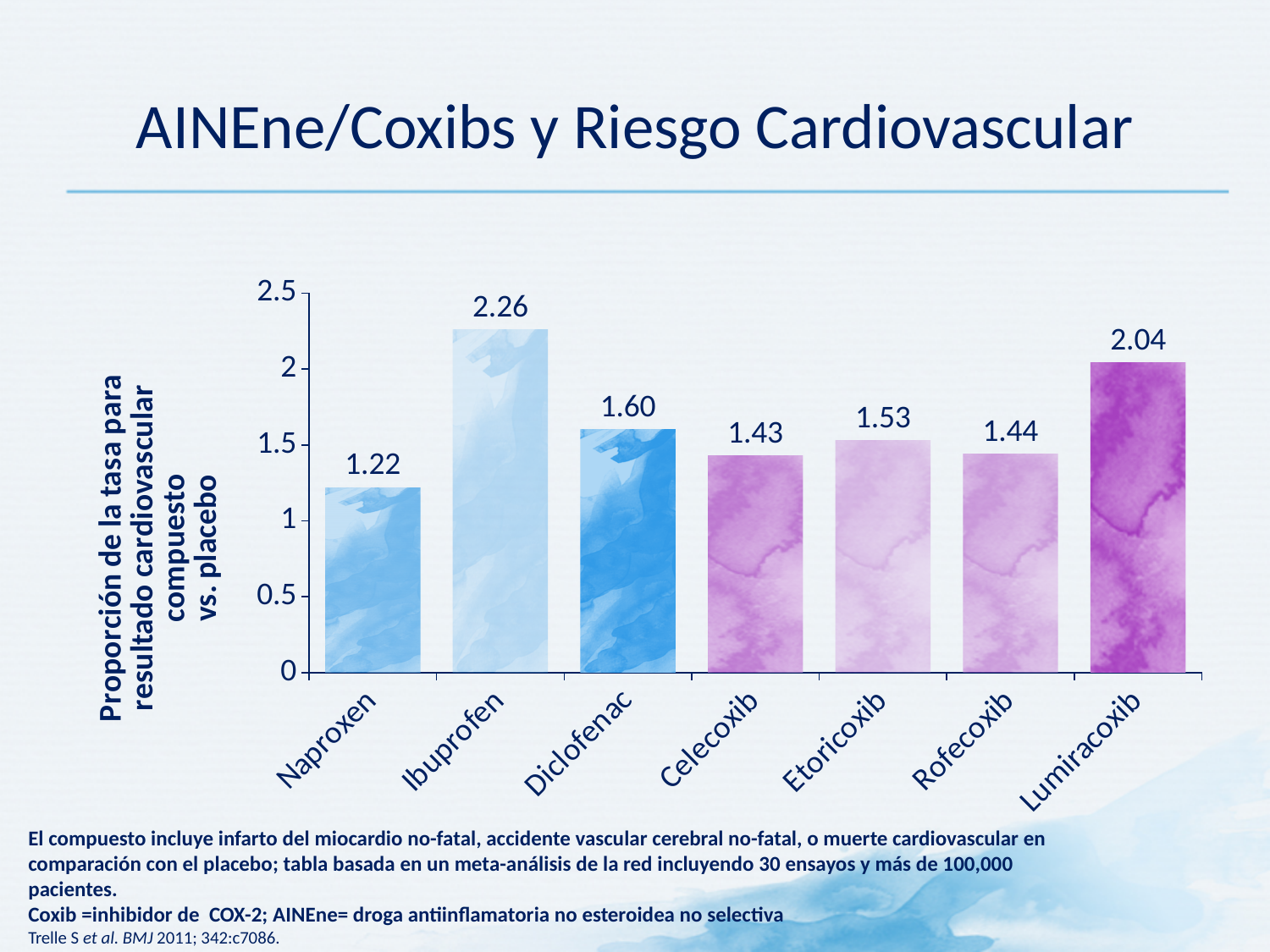
What is the difference between the values for Ibuprofen and Naproxen? 1.04 What is the difference between the values for Lumiracoxib and Diclofenac? 0.44 What is the value for Celecoxib? 1.43 How many categories are shown on the x axis? 7 What is the value for Lumiracoxib? 2.04 Which category has the lowest value? Naproxen What kind of chart is shown on the slide? bar chart What is the title of the slide? AINEne/Coxibs y Riesgo Cardiovascular What is the value for Ibuprofen? 2.26 Is the value for Diclofenac greater or less than 1.5? greater Which category has the highest value? Ibuprofen Which has a larger value, Etoricoxib or Rofecoxib? Etoricoxib